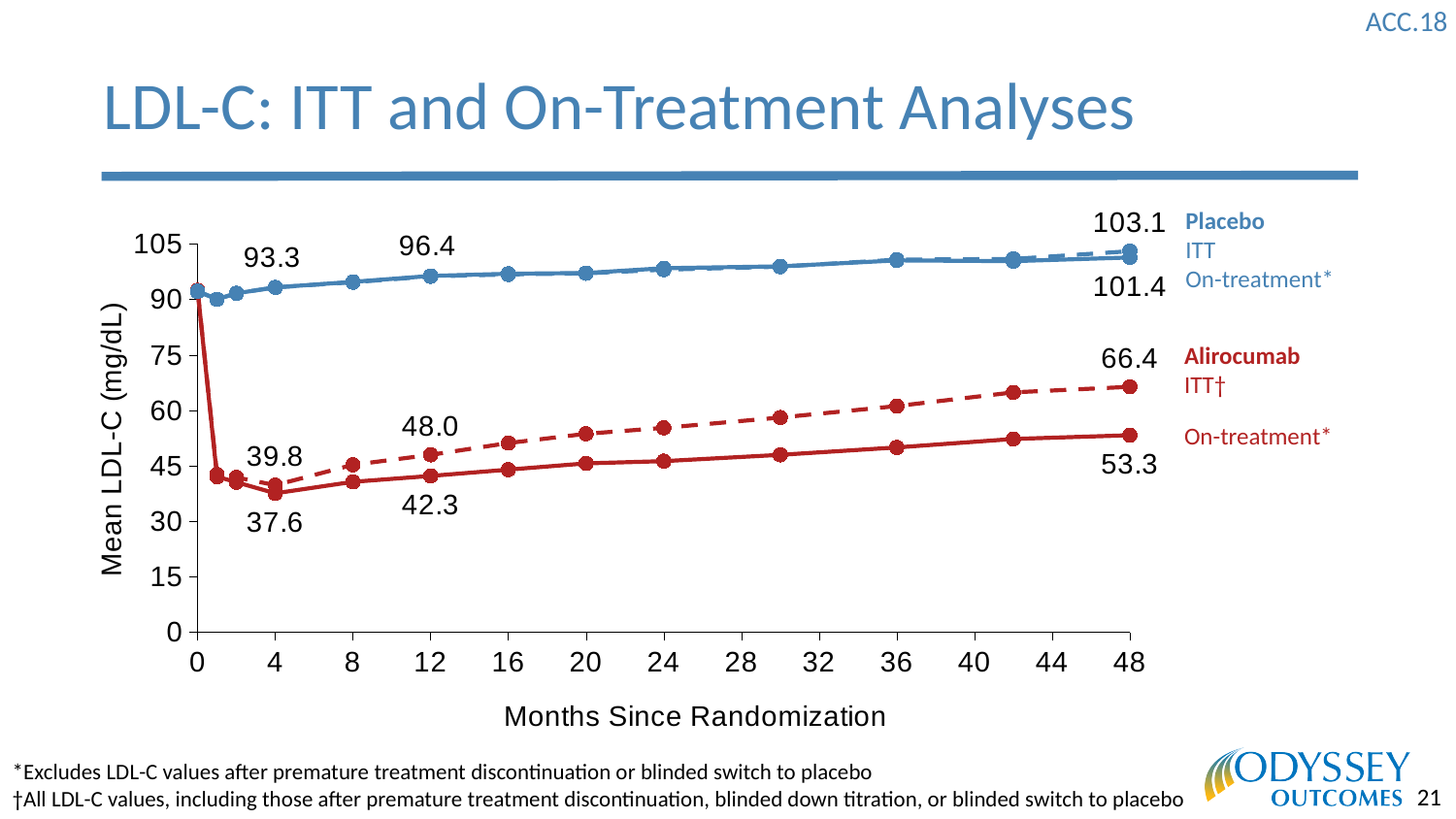
What is the mean LDL-C for Alirocumab On-treatment at 4 months? 37.6 What is the mean LDL-C for Alirocumab ITT at 48 months? 66.4 At 48 months, which is higher: Placebo ITT or Alirocumab ITT? Placebo ITT Does the Alirocumab ITT line rise or fall between month 4 and month 48? rises Is the Alirocumab On-treatment value at 24 months greater or less than 60? less What is the title of the x axis? Months Since Randomization What is the mean LDL-C for Alirocumab On-treatment at 48 months? 53.3 What is the mean LDL-C for Placebo ITT at 48 months? 103.1 What kind of chart is shown on the slide? line chart What is the mean LDL-C for Alirocumab ITT at 12 months? 48.0 What is the mean LDL-C for Placebo On-treatment at 48 months? 101.4 At 48 months, what is the difference between the Alirocumab ITT and Alirocumab On-treatment values? 13.1